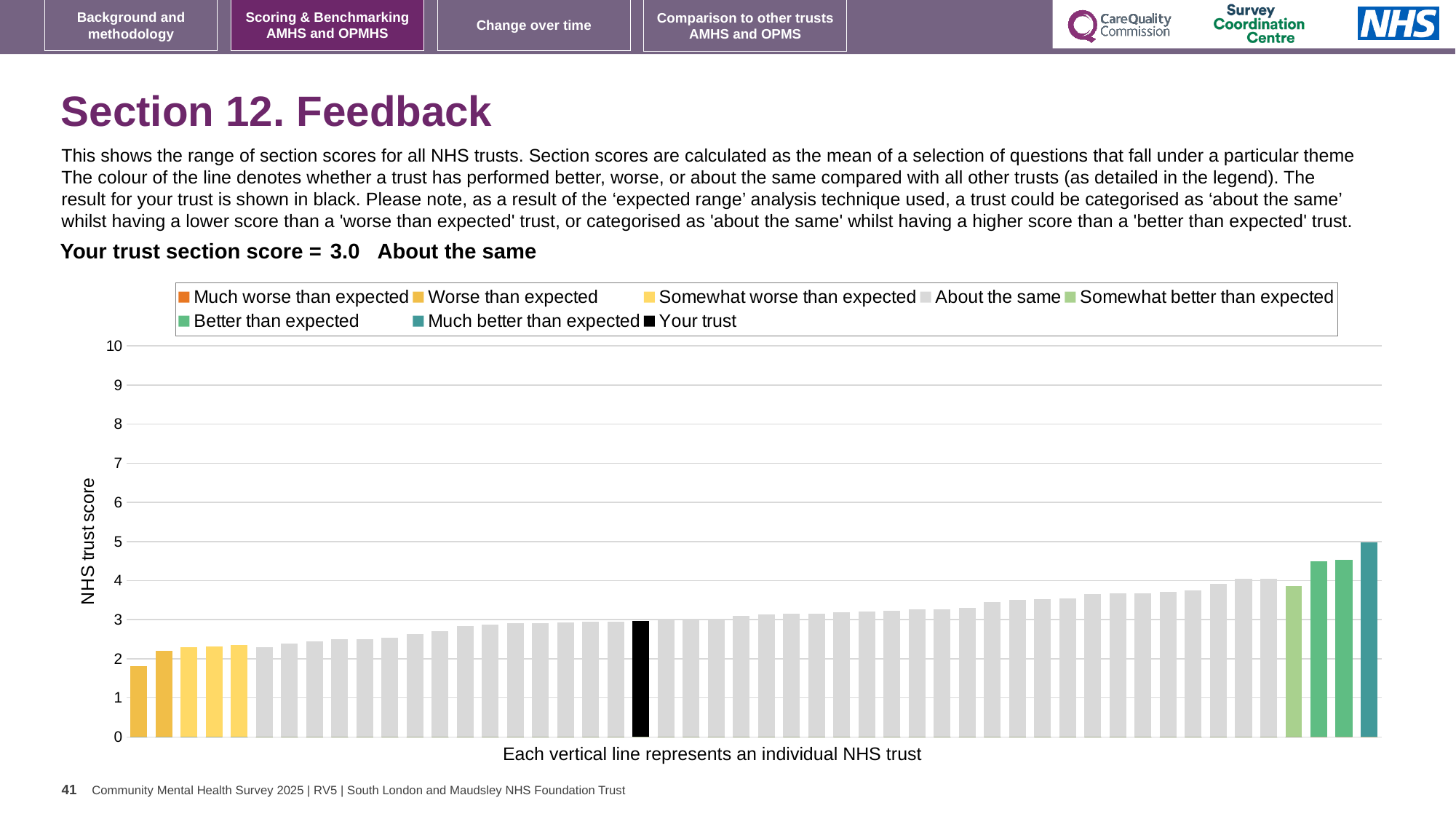
Is the value of the tallest bar greater or less than 4? greater What is the section score for your trust shown on the slide? 3.0 How many entries does the chart legend list? 8 What is the highest value shown on the vertical axis? 10 Which category is your trust placed in according to the slide? About the same Is the value of the shortest bar greater or less than 2? less What is the label on the vertical axis? NHS trust score What colour is the bar representing your trust? black How many bars are coloured teal (Much better than expected)? 1 Which legend category does the tallest bar belong to? Much better than expected Do the bar values rise or fall from left to right along the x axis? rise What kind of chart is shown on the slide? bar chart